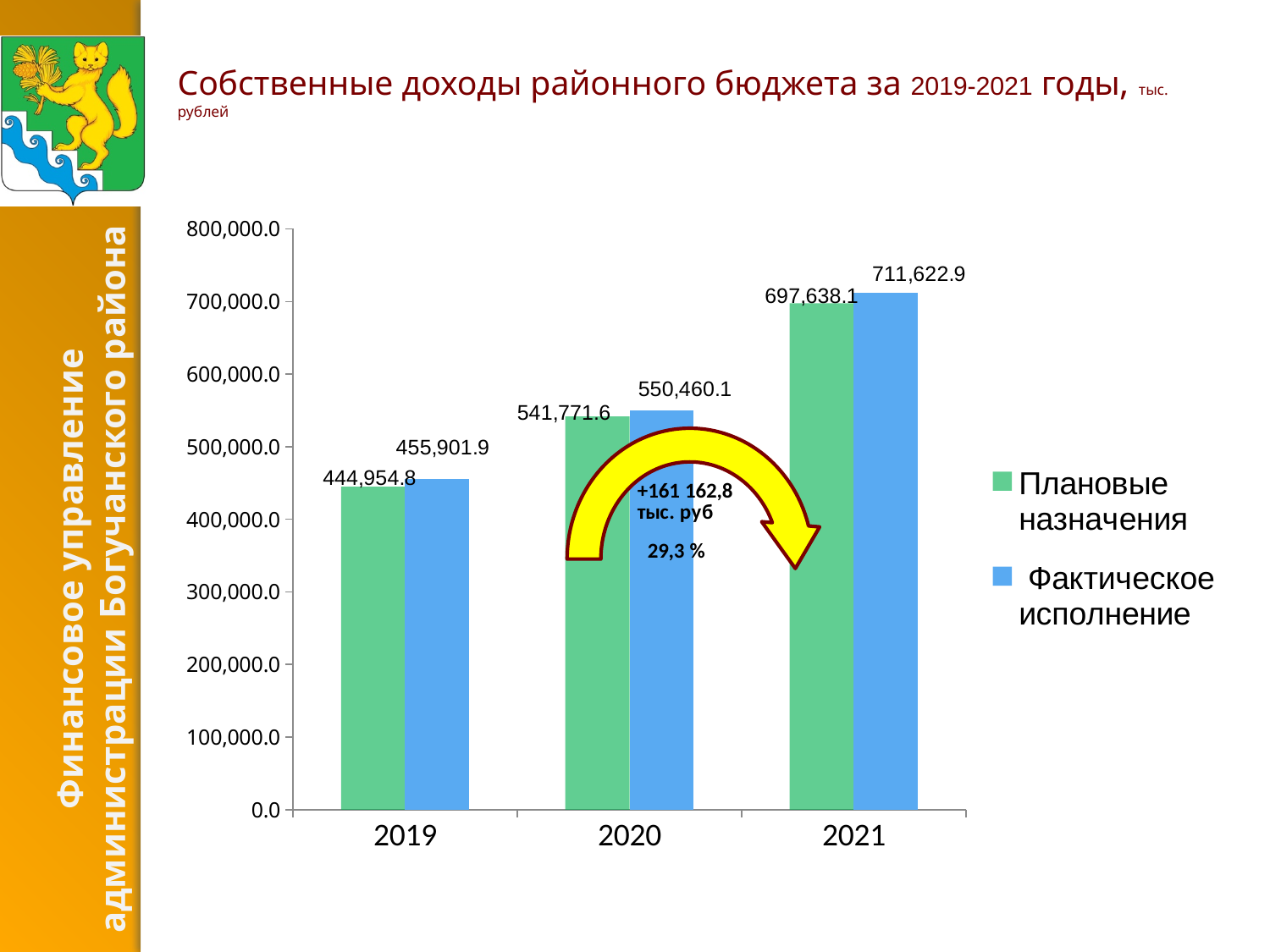
What is the difference between Фактическое исполнение in 2021 and in 2020? 161,162.8 What is the value of Фактическое исполнение for 2021? 711,622.9 Do the Фактическое исполнение values rise or fall from 2019 to 2021? rise How many series does the legend list? 2 In which year is Плановые назначения the lowest? 2019 What type of chart is shown on the slide? bar chart What is the value of Плановые назначения for 2020? 541,771.6 In which year is Фактическое исполнение the highest? 2021 Which is larger in 2020: Плановые назначения or Фактическое исполнение? Фактическое исполнение What is the value of Плановые назначения for 2019? 444,954.8 How many years are shown on the x axis? 3 What is the difference between Фактическое исполнение and Плановые назначения in 2021? 13,984.8